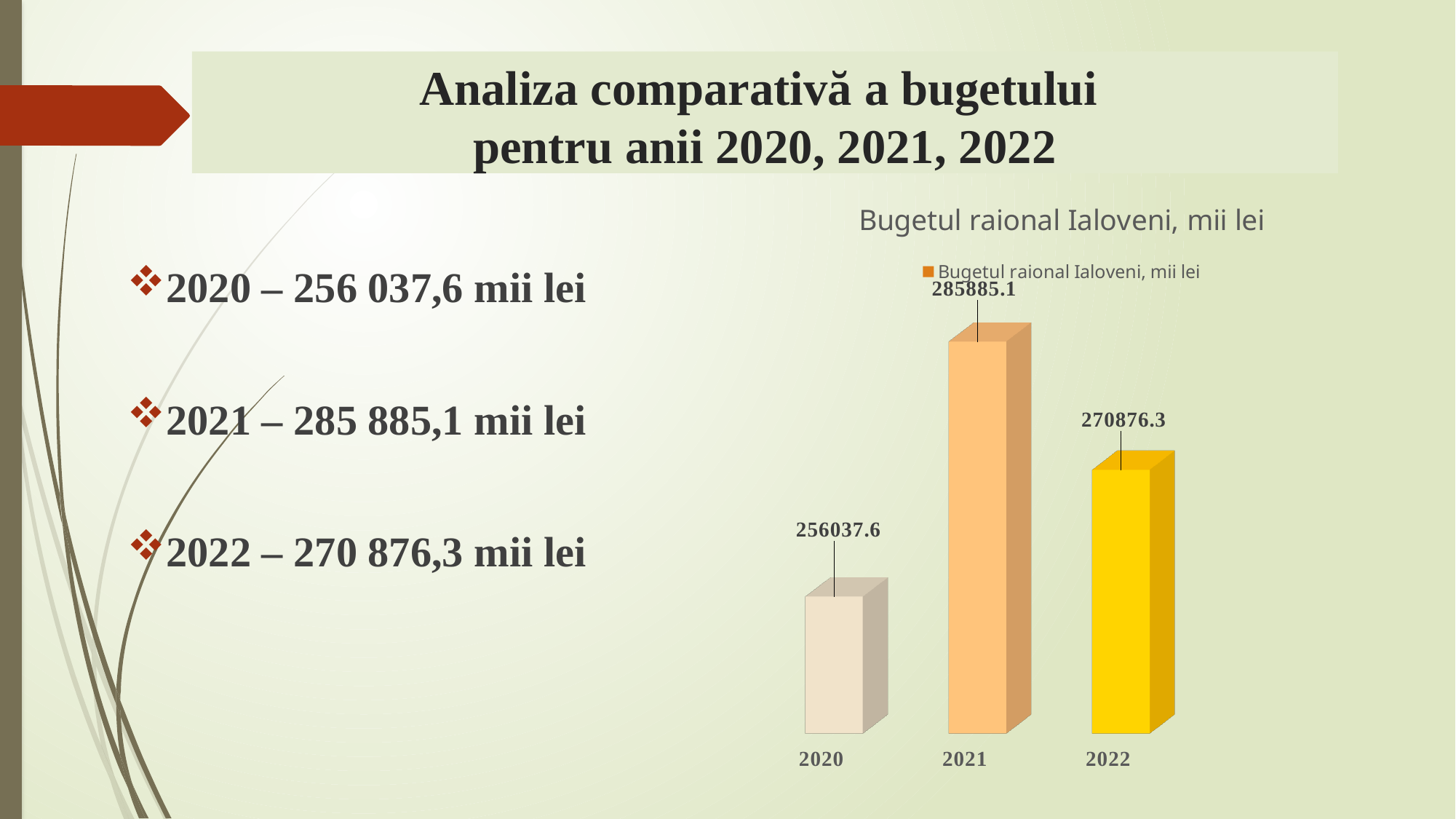
What kind of chart is shown on the slide? bar chart How many series does the chart legend list? 1 Which year has the lowest value in the chart? 2020 What is the difference between the values for 2021 and 2020? 29847.5 What is the value for 2020 in the chart? 256037.6 What is the title of the chart? Bugetul raional Ialoveni, mii lei How many years are shown in the chart? 3 What is the difference between the values for 2021 and 2022? 15008.8 What is the value for 2021 in the chart? 285885.1 Which year has the highest value in the chart? 2021 Which is larger, the value for 2022 or the value for 2020? 2022 What is the value for 2022 in the chart? 270876.3